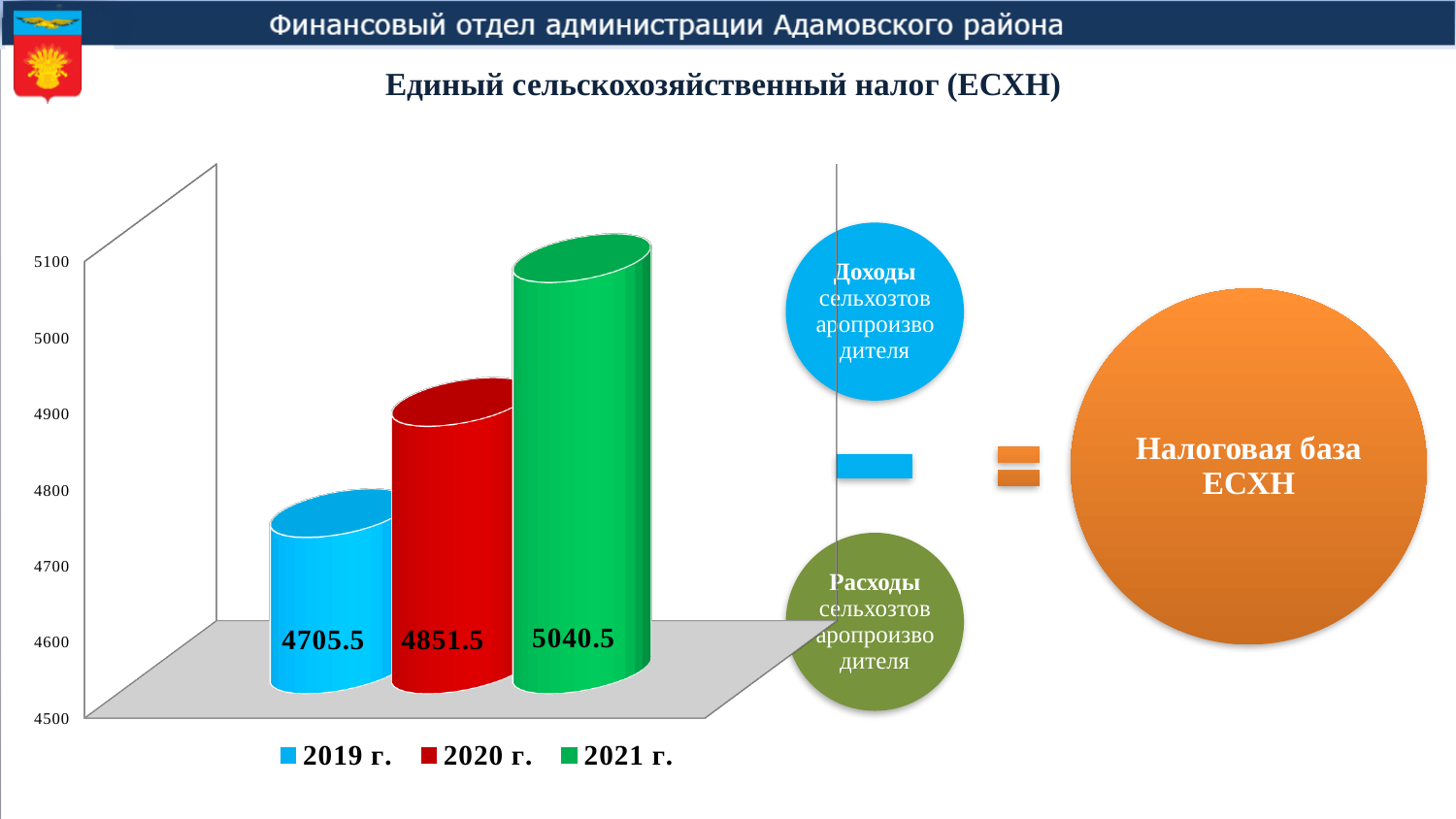
How many series does the legend list? 3 Is the value for 2021 г. greater or less than 5000? greater What is the value for 2020 г.? 4851.5 What is the difference between the values for 2020 г. and 2019 г.? 146 What is the value for 2019 г.? 4705.5 What is the value for 2021 г.? 5040.5 Which year has the highest value? 2021 г. What kind of chart is shown on the slide? bar chart Do the values rise or fall from 2019 г. to 2021 г.? rise What is the difference between the values for 2021 г. and 2020 г.? 189 Which is larger, the value for 2019 г. or the value for 2020 г.? 2020 г. Which year has the lowest value? 2019 г.